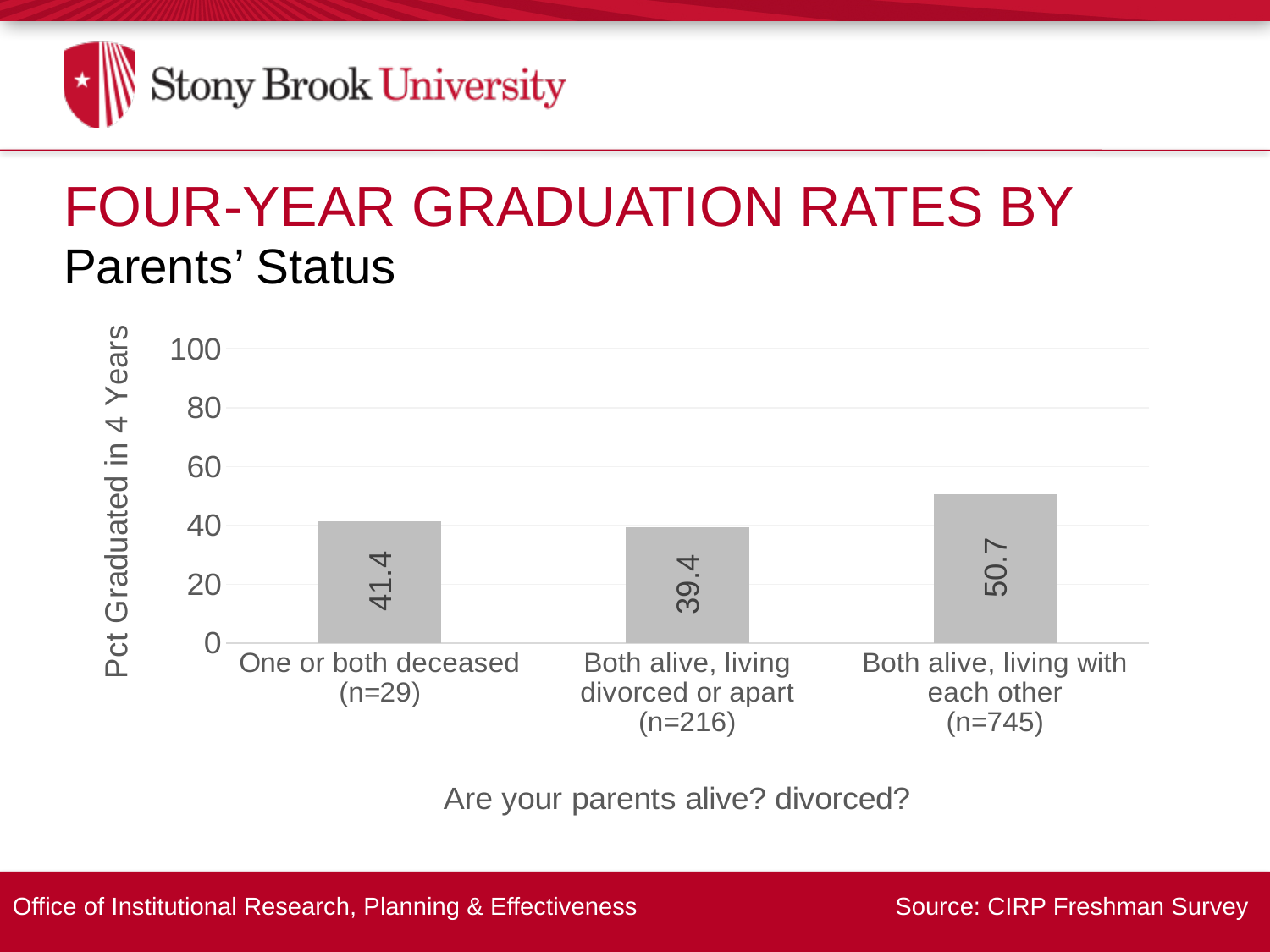
What is the four-year graduation rate for students whose parents are both alive, living with each other (n=745)? 50.7 Which has a higher four-year graduation rate: 'One or both deceased' or 'Both alive, living with each other'? Both alive, living with each other Which parents' status category has the lowest four-year graduation rate? Both alive, living divorced or apart (n=216) What is the four-year graduation rate for students whose parents are both alive, living divorced or apart (n=216)? 39.4 What is the difference in four-year graduation rate between 'One or both deceased' and 'Both alive, living divorced or apart'? 2.0 What is the four-year graduation rate for students with one or both parents deceased (n=29)? 41.4 What is the difference in four-year graduation rate between 'Both alive, living with each other' and 'Both alive, living divorced or apart'? 11.3 What is the label of the vertical axis of the chart? Pct Graduated in 4 Years What type of chart is shown on the slide? Bar chart How many parents' status categories are shown in the chart? 3 Which parents' status category has the highest four-year graduation rate? Both alive, living with each other (n=745) Is the four-year graduation rate for 'Both alive, living with each other' greater or less than 40? greater